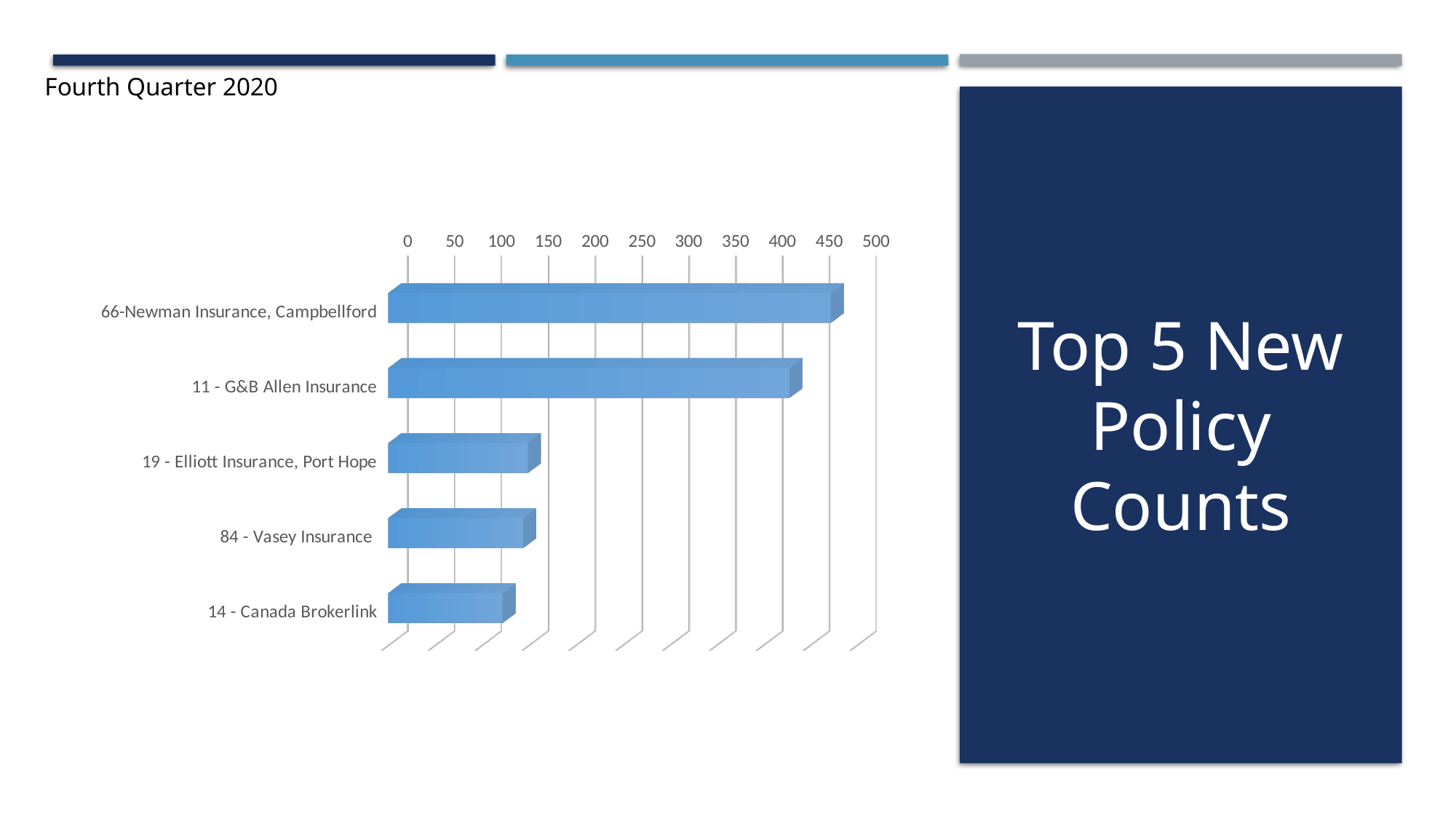
Which broker has the highest new policy count? 66-Newman Insurance, Campbellford Is the value for 14 - Canada Brokerlink greater or less than 150? less How many brokers (categories) are plotted in the chart? 5 What is the title shown in the panel next to the chart? Top 5 New Policy Counts Which has the larger value: 11 - G&B Allen Insurance or 19 - Elliott Insurance, Port Hope? 11 - G&B Allen Insurance Is the value for 84 - Vasey Insurance greater or less than 100? greater Which has the larger value: 66-Newman Insurance, Campbellford or 11 - G&B Allen Insurance? 66-Newman Insurance, Campbellford Is the value for 19 - Elliott Insurance, Port Hope greater or less than 200? less Which broker has the lowest new policy count? 14 - Canada Brokerlink What kind of chart is shown on the slide? Bar chart